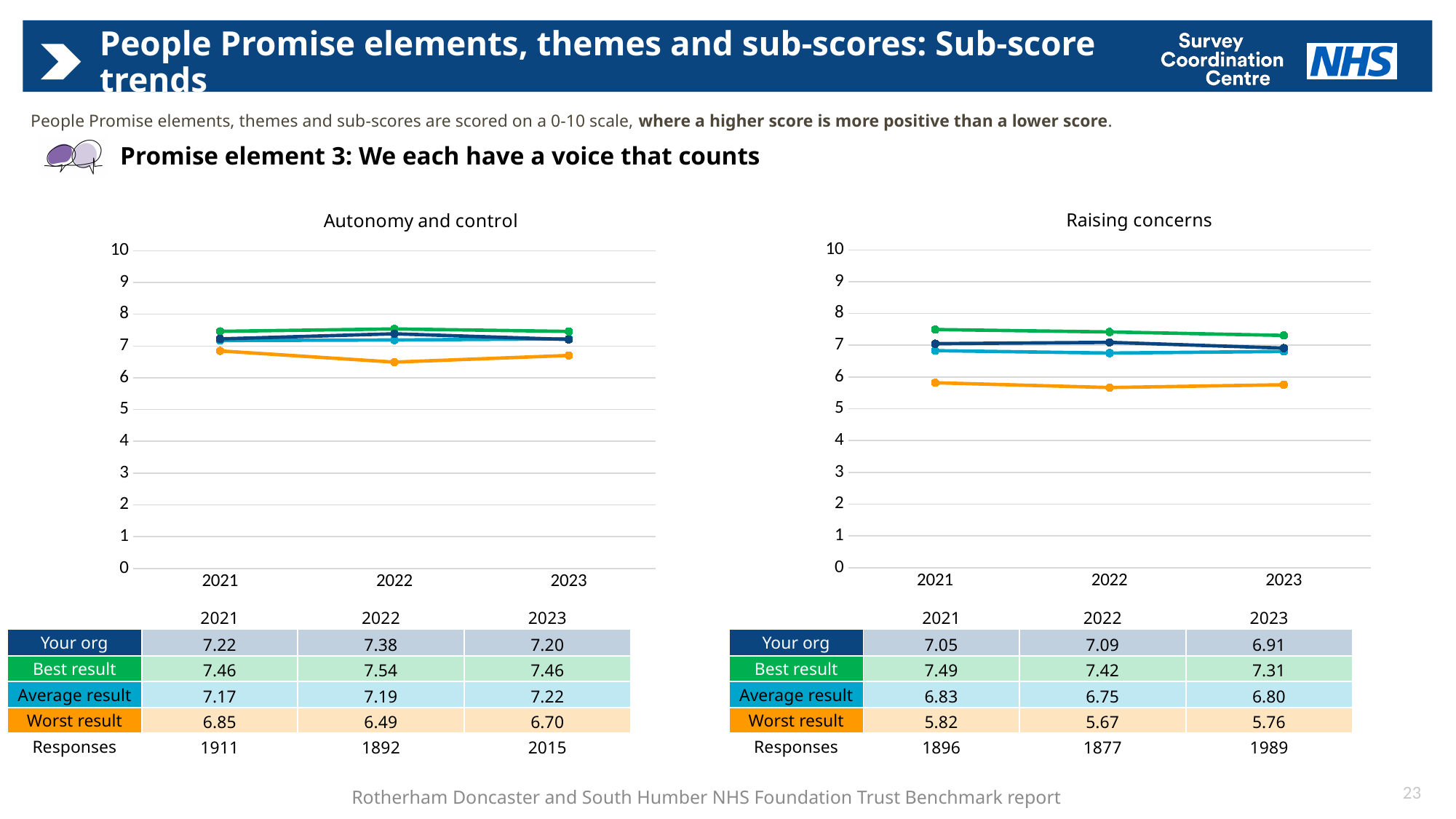
In the 'Raising concerns' chart, what is the 'Worst result' value for 2021? 5.82 In the 'Autonomy and control' chart, what is the difference between the 'Your org' values for 2022 and 2023? 0.18 In the 'Autonomy and control' chart, which year has the highest 'Best result' value? 2022 In the 'Raising concerns' chart, what is the difference between the 'Best result' and 'Your org' values for 2023? 0.40 In the 'Raising concerns' chart, is the 'Worst result' value for 2022 greater or less than 6? less In the 'Raising concerns' chart, is the 'Your org' value for 2021 larger or smaller than the 'Average result' value for 2021? larger How many series are shown in the 'Raising concerns' chart? 4 In the 'Raising concerns' chart, what is the 'Average result' value for 2023? 6.80 What type of chart is the 'Autonomy and control' chart? line chart In the 'Autonomy and control' chart, what is the 'Your org' value for 2022? 7.38 How many years are plotted on the x axis of the 'Autonomy and control' chart? 3 In the 'Autonomy and control' chart, which year has the lowest 'Worst result' value? 2022